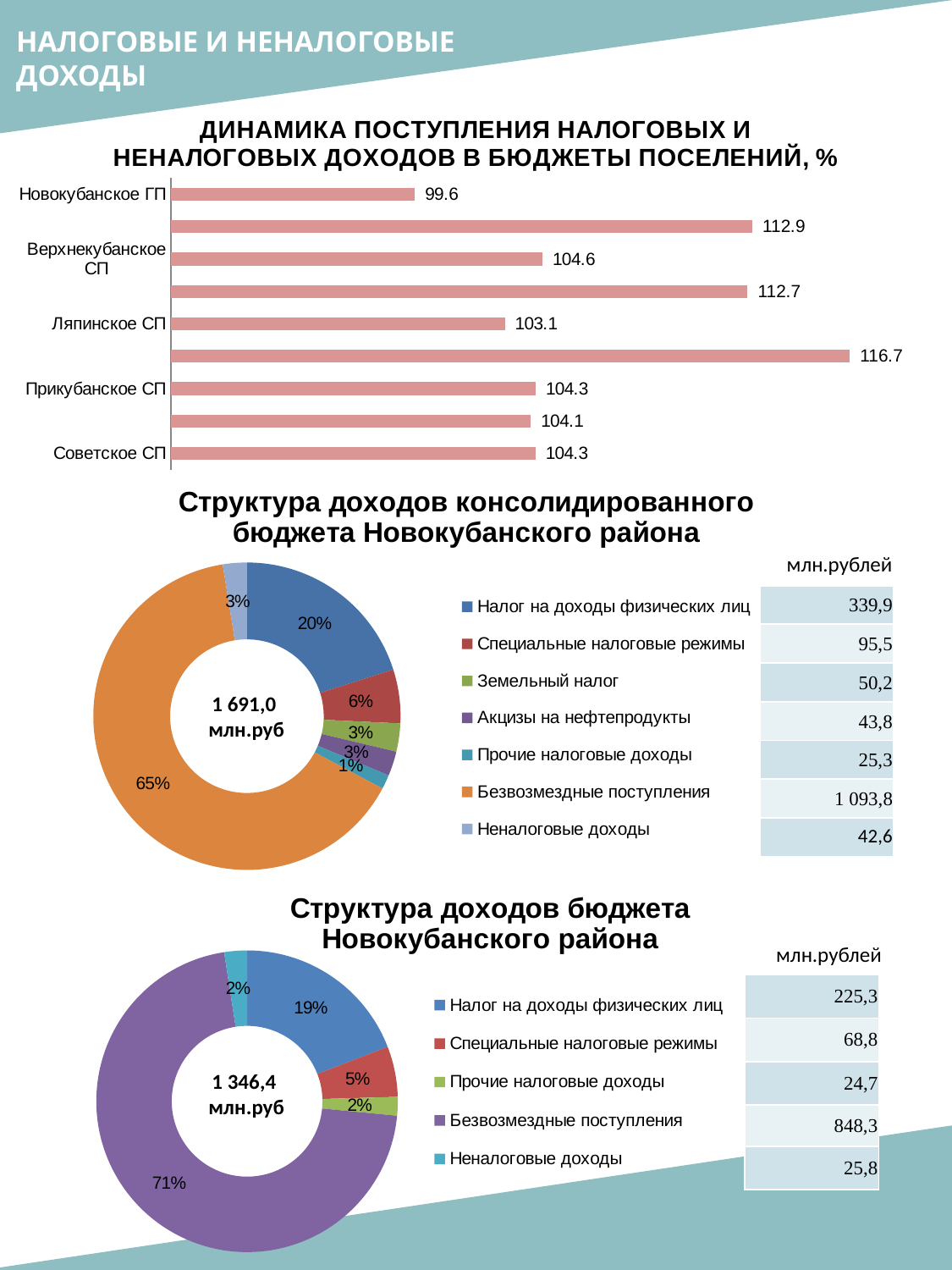
In the bar chart 'Динамика поступления налоговых и неналоговых доходов в бюджеты поселений, %', what is the value for Новокубанское ГП? 99.6 What kind of chart is 'Структура доходов бюджета Новокубанского района'? Doughnut (pie) chart In the bar chart 'Динамика поступления налоговых и неналоговых доходов в бюджеты поселений, %', what is the difference between the values for Верхнекубанское СП and Ляпинское СП? 1.5 In the bar chart 'Динамика поступления налоговых и неналоговых доходов в бюджеты поселений, %', which is larger: the value for Прикубанское СП or Новокубанское ГП? Прикубанское СП How many entries does the legend list in the chart 'Структура доходов консолидированного бюджета Новокубанского района'? 7 In the bar chart 'Динамика поступления налоговых и неналоговых доходов в бюджеты поселений, %', what is the highest value shown on any bar? 116.7 How many bars are plotted in the bar chart 'Динамика поступления налоговых и неналоговых доходов в бюджеты поселений, %'? 9 In the chart 'Структура доходов консолидированного бюджета Новокубанского района', what share of the total is Безвозмездные поступления? 65% In the bar chart 'Динамика поступления налоговых и неналоговых доходов в бюджеты поселений, %', which labelled category has the lowest value? Новокубанское ГП In the chart 'Структура доходов бюджета Новокубанского района', what is the value in млн.рублей for Безвозмездные поступления? 848,3 In the bar chart 'Динамика поступления налоговых и неналоговых доходов в бюджеты поселений, %', what is the value for Ляпинское СП? 103.1 In the chart 'Структура доходов консолидированного бюджета Новокубанского района', what is the value in млн.рублей for Налог на доходы физических лиц? 339,9